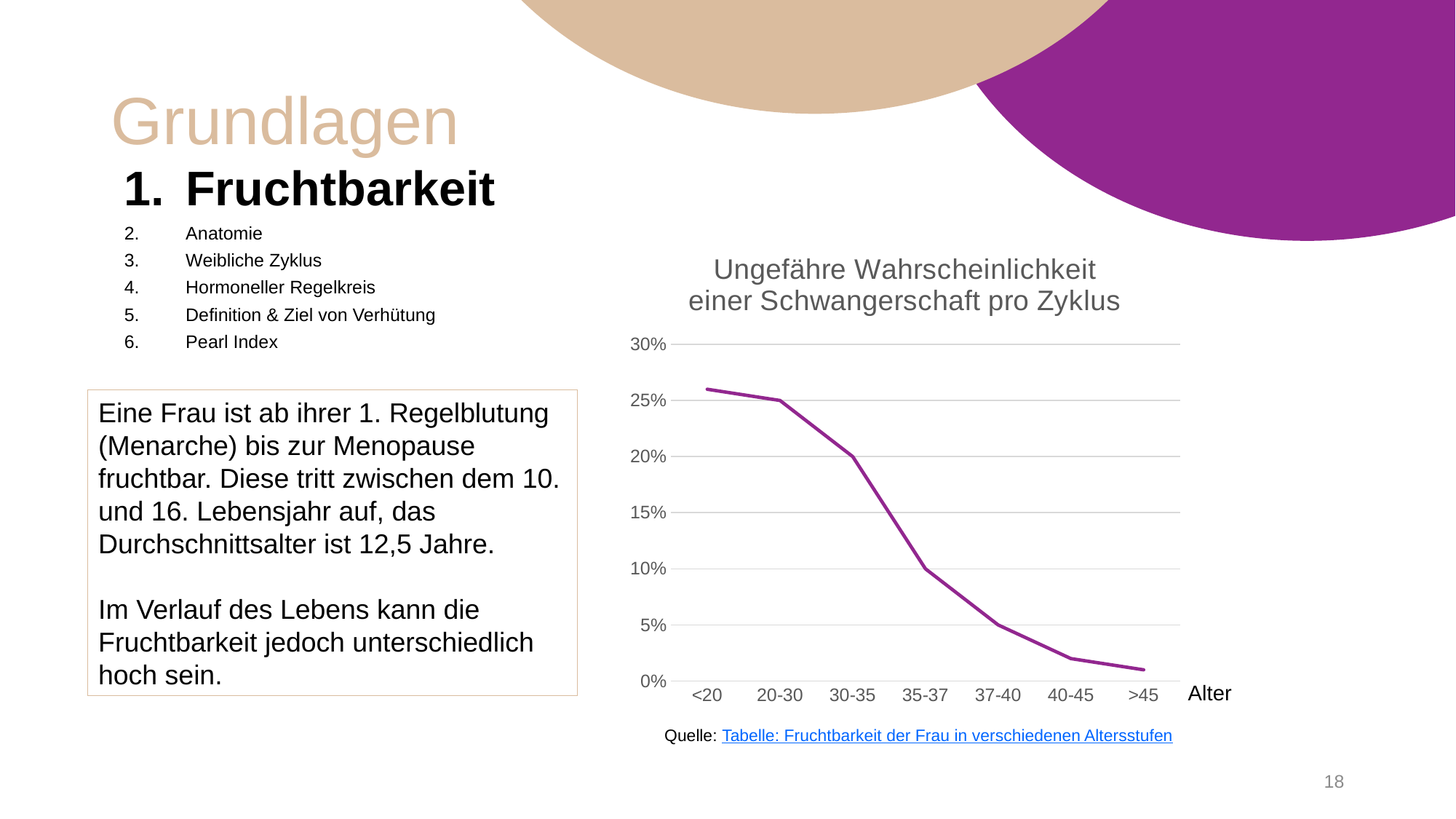
What is the probability of pregnancy per cycle for the 20-30 age group? 25% Which age group has the highest probability of pregnancy per cycle in the chart? <20 Is the value for the 40-45 age group greater or less than 5%? less What is the probability of pregnancy per cycle for the 35-37 age group? 10% How many age categories are plotted along the x axis of the chart? 7 What is the probability of pregnancy per cycle for the 30-35 age group? 20% Do the values rise or fall as age increases along the x axis? fall Which age group has a higher value, 30-35 or 37-40? 30-35 Is the value for the <20 age group greater or less than 25%? greater What is the title of the chart? Ungefähre Wahrscheinlichkeit einer Schwangerschaft pro Zyklus Which age group has the lowest probability of pregnancy per cycle in the chart? >45 What kind of chart is shown on the slide? line chart